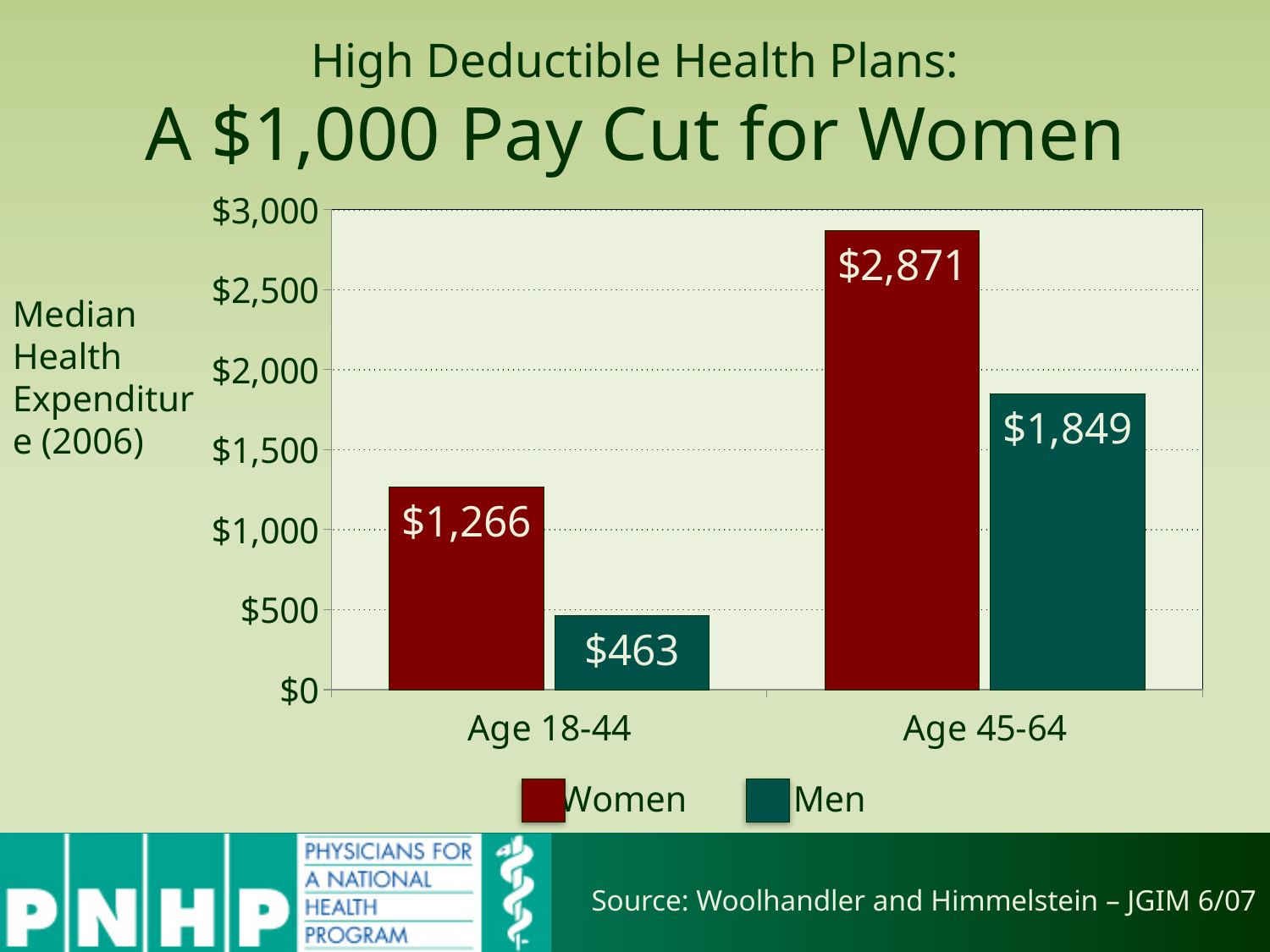
How many age groups are shown on the x axis? 2 What is the difference between the median health expenditure for women and men aged 45-64? $1,022 How many series does the legend list? 2 Which group has the highest median health expenditure? Women, Age 45-64 What is the difference between the median health expenditure for women and men aged 18-44? $803 Is the median health expenditure for women aged 45-64 greater or less than $2,500? greater What is the median health expenditure for men aged 45-64? $1,849 What kind of chart is shown on the slide? Bar chart Which is larger: the median health expenditure for women aged 18-44 or for men aged 45-64? Men aged 45-64 Which group has the lowest median health expenditure? Men, Age 18-44 What is the median health expenditure for women aged 18-44? $1,266 What is the median health expenditure for men aged 18-44? $463